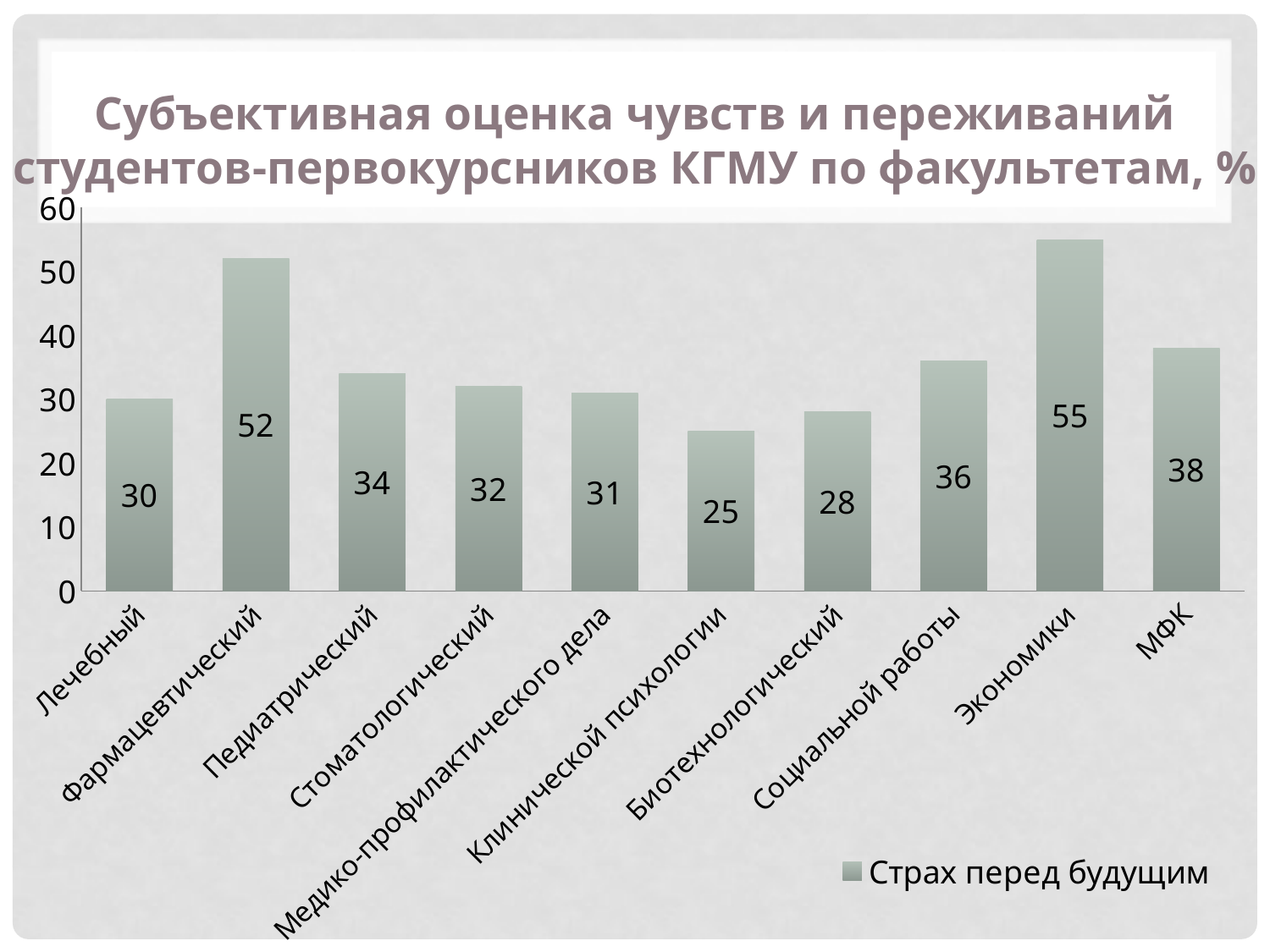
What is the difference between the values for Экономики and Лечебный? 25 How many faculties are shown on the x axis? 10 How many series does the legend list? 1 What kind of chart is shown on the slide? bar chart Which is larger, the value for Социальной работы or the value for Биотехнологический? Социальной работы What is the value for МФК? 38 Is the value for Педиатрический greater or less than 30? greater Which faculty has the highest value? Экономики What is the legend entry for the series shown? Страх перед будущим What is the value for Фармацевтический? 52 Which faculty has the lowest value? Клинической психологии What is the value for Клинической психологии? 25